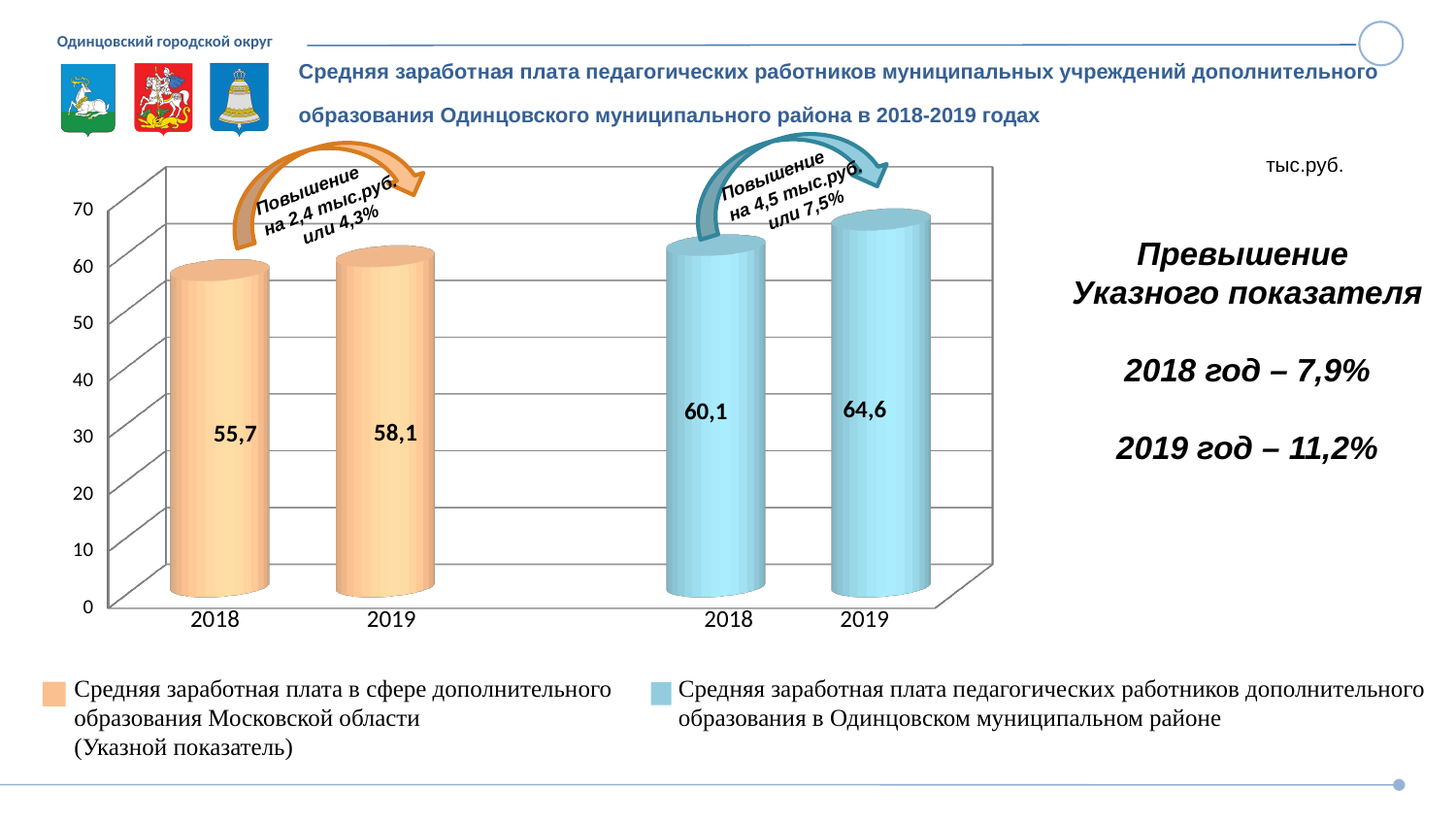
What is the 2019 value for the average salary of teaching staff of additional education in the Odintsovo municipal district? 64,6 What is the difference between the 2019 Odintsovo district value and the 2019 Moscow region value? 6,5 What is the 2018 value for the average salary in the sphere of additional education of the Moscow region (Указной показатель)? 55,7 What type of chart is shown on the slide? Bar chart Which bar has the highest value on the chart? 2019, Odintsovo municipal district (64,6) Which bar has the lowest value on the chart? 2018, Moscow region (55,7) What is the 2018 value for the average salary of teaching staff of additional education in the Odintsovo municipal district? 60,1 Which is larger in 2018: the Moscow region value or the Odintsovo municipal district value? Odintsovo municipal district By how much did the Odintsovo municipal district teachers' average salary increase from 2018 to 2019? 4,5 How many series does the legend list? 2 What unit of measurement is indicated for the chart values? тыс.руб. What is the 2019 value for the Moscow region average salary in additional education (Указной показатель)? 58,1